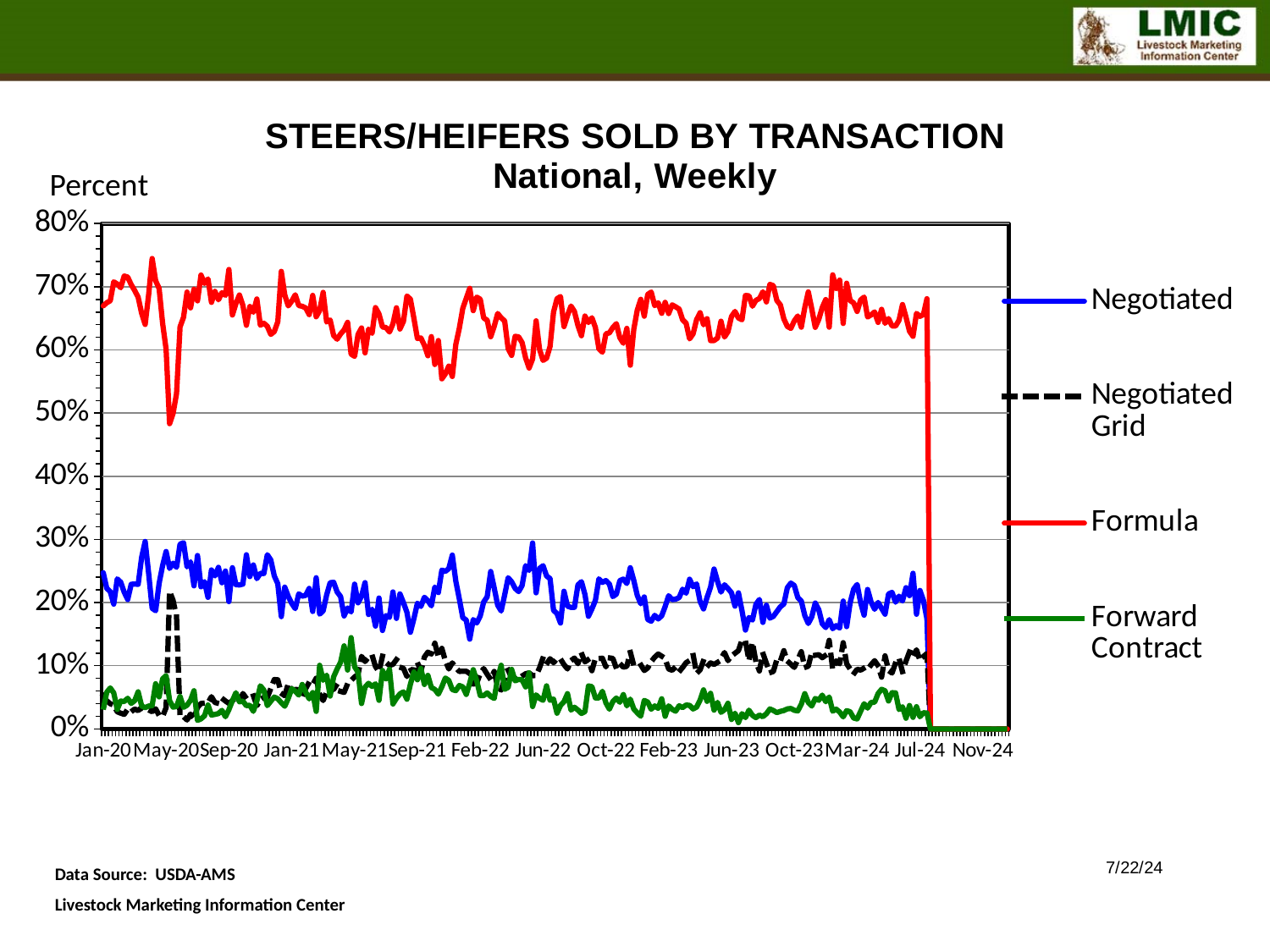
Does the Negotiated Grid series generally rise or fall from 2020 to 2023? rise What is the title of the chart? STEERS/HEIFERS SOLD BY TRANSACTION National, Weekly Which series has the highest values throughout the chart? Formula Is the value for Negotiated in Jun-22 greater or less than 40%? less What label is shown on the vertical axis? Percent How many series does the legend list? 4 Is the value for Formula in Jan-21 greater or less than 50%? greater Which is larger in Oct-22, Negotiated or Forward Contract? Negotiated Which is larger in Feb-23, Formula or Negotiated? Formula Which series has the lowest values during 2023? Forward Contract Is the value for Forward Contract in Mar-24 greater or less than 20%? less What kind of chart is shown on the slide? line chart